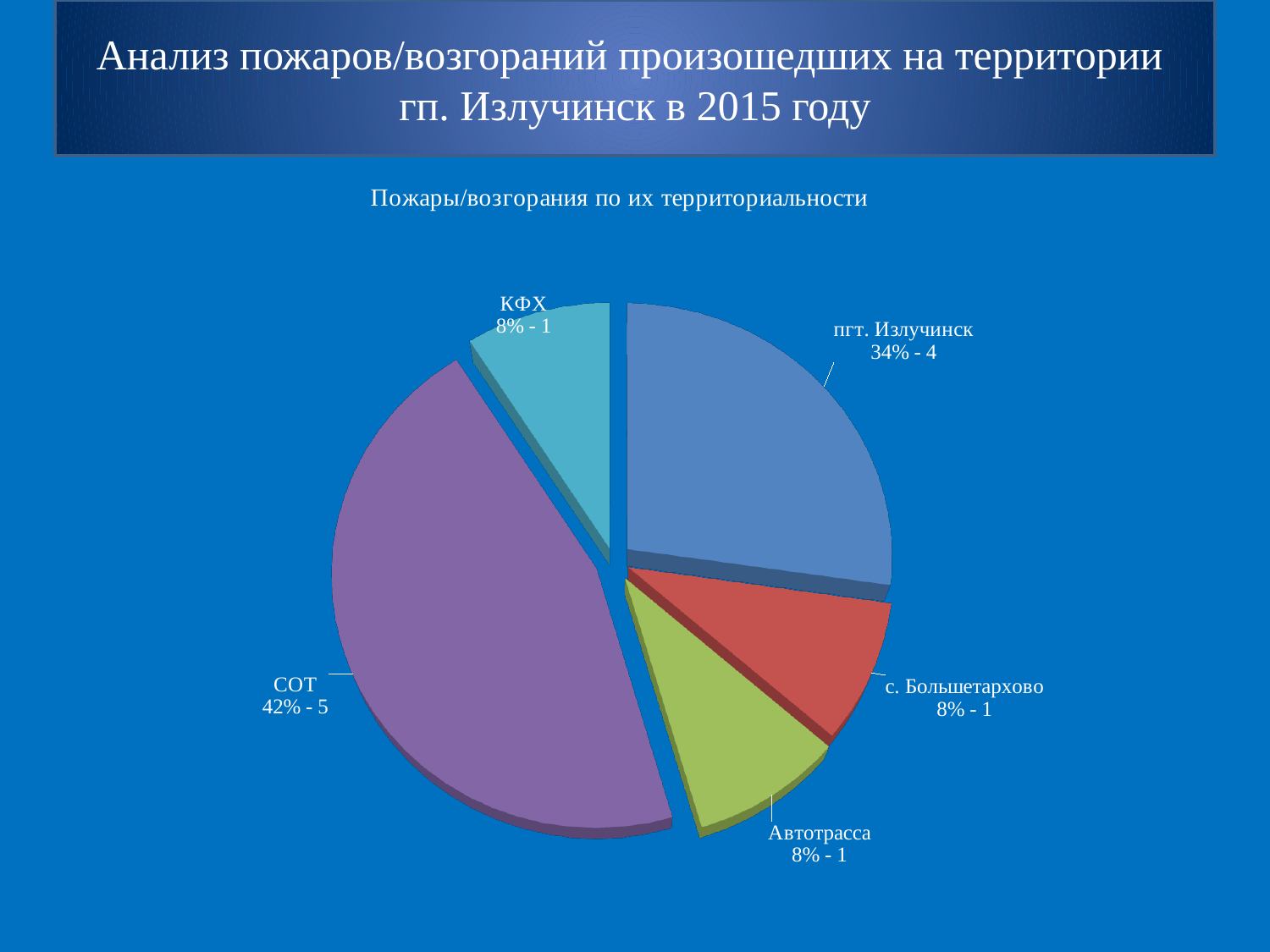
What share of the pie does пгт. Излучинск account for? 34% How many fires are shown for СОТ? 5 How many fires are shown for пгт. Излучинск? 4 Which category has the largest slice? СОТ What is the title of the chart? Пожары/возгорания по их территориальности What share of the pie does СОТ account for? 42% Which is larger, the share for пгт. Излучинск or the share for с. Большетархово? пгт. Излучинск How many slices does the pie chart have? 5 What is the total number of fires across all slices? 12 How many fires are shown for Автотрасса? 1 What kind of chart is shown on the slide? pie chart What is the difference in the number of fires between СОТ and пгт. Излучинск? 1